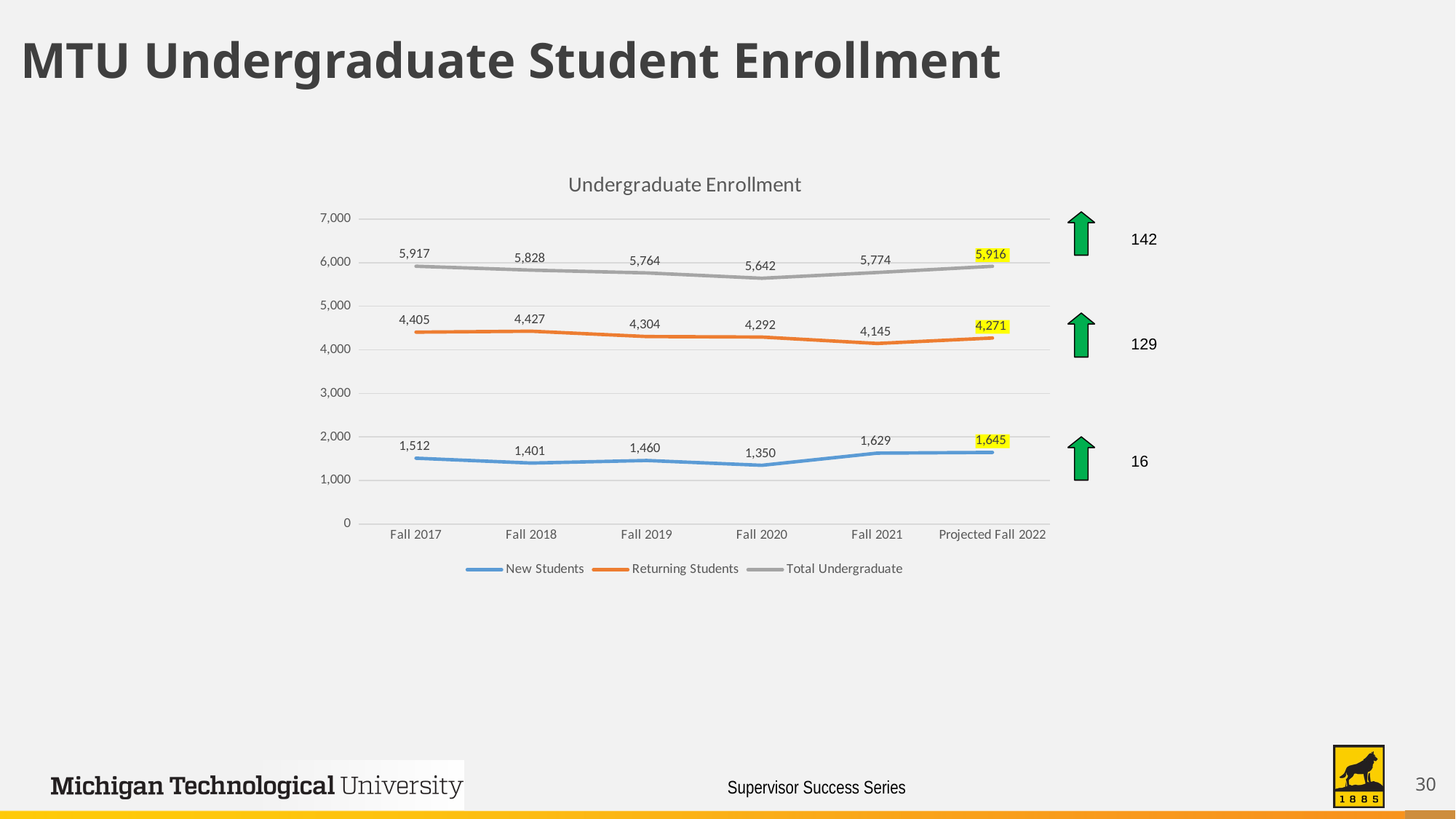
How many series does the legend list? 3 What is the difference between the Total Undergraduate values for Fall 2017 and Fall 2020? 275 In which period is the New Students value highest? Projected Fall 2022 What is the title of the chart? Undergraduate Enrollment In which period is the Total Undergraduate enrollment lowest? Fall 2020 What is the Returning Students value for Projected Fall 2022? 4,271 How many periods are shown on the x axis? 6 What is the Total Undergraduate enrollment for Fall 2020? 5,642 In which period is the Returning Students value lowest? Fall 2021 Which is larger: Returning Students in Fall 2018 or Returning Students in Fall 2019? Fall 2018 What is the New Students value for Fall 2021? 1,629 What kind of chart is shown on the slide? Line chart